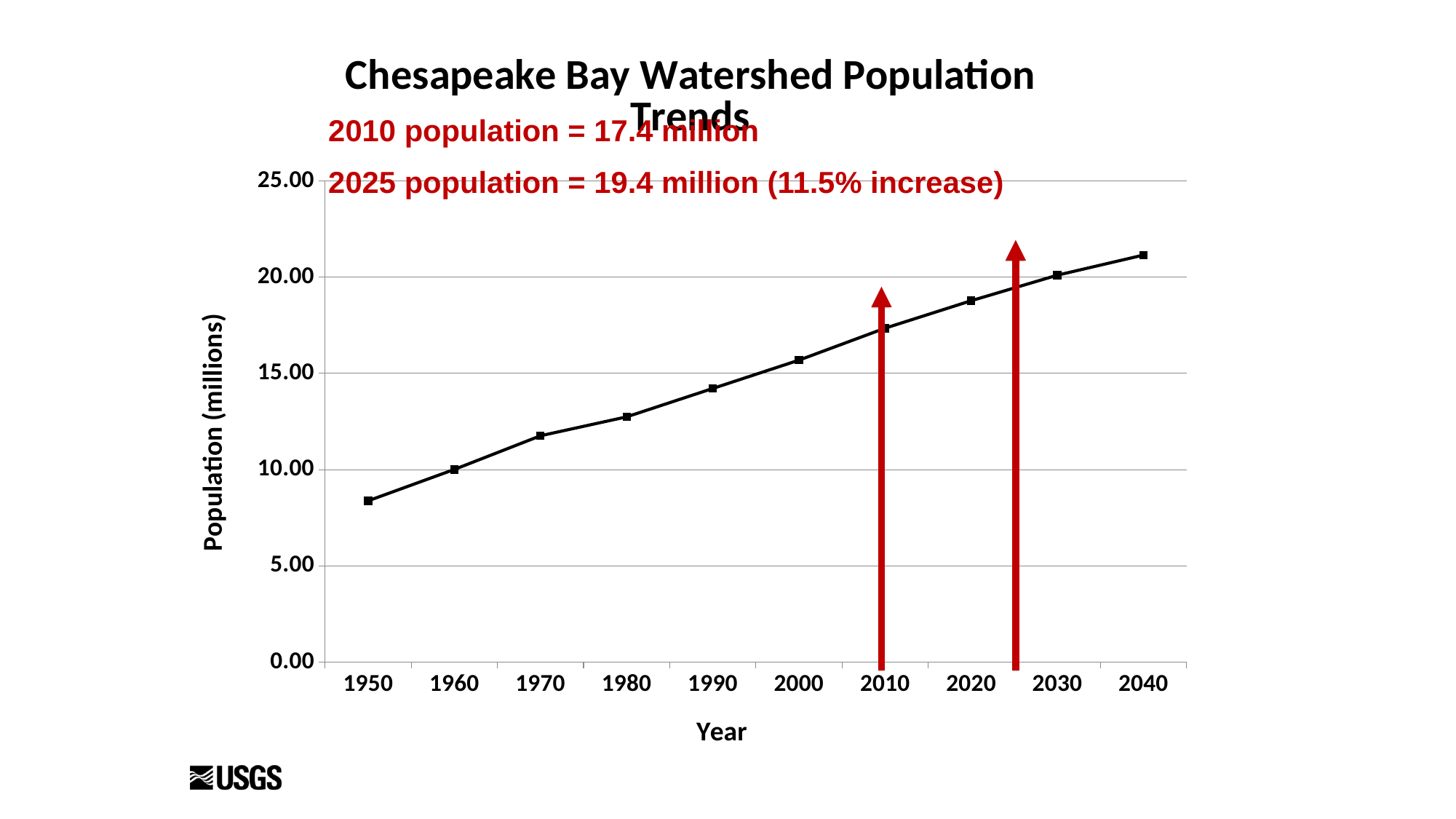
Is the population value for 1980 greater or less than 15.00? less According to the annotation on the slide, what is the 2010 population? 17.4 million How many data points are plotted on the line? 10 Which year has the highest plotted population? 2040 Is the population value for 1950 greater or less than 10.00? less Which year has the lowest plotted population? 1950 What kind of chart is shown on the slide? line chart Is the population value for 2000 greater or less than 15.00? greater Which year has the larger population, 1970 or 1990? 1990 What is the label on the vertical axis? Population (millions) Do the population values rise or fall from 1950 to 2040? rise